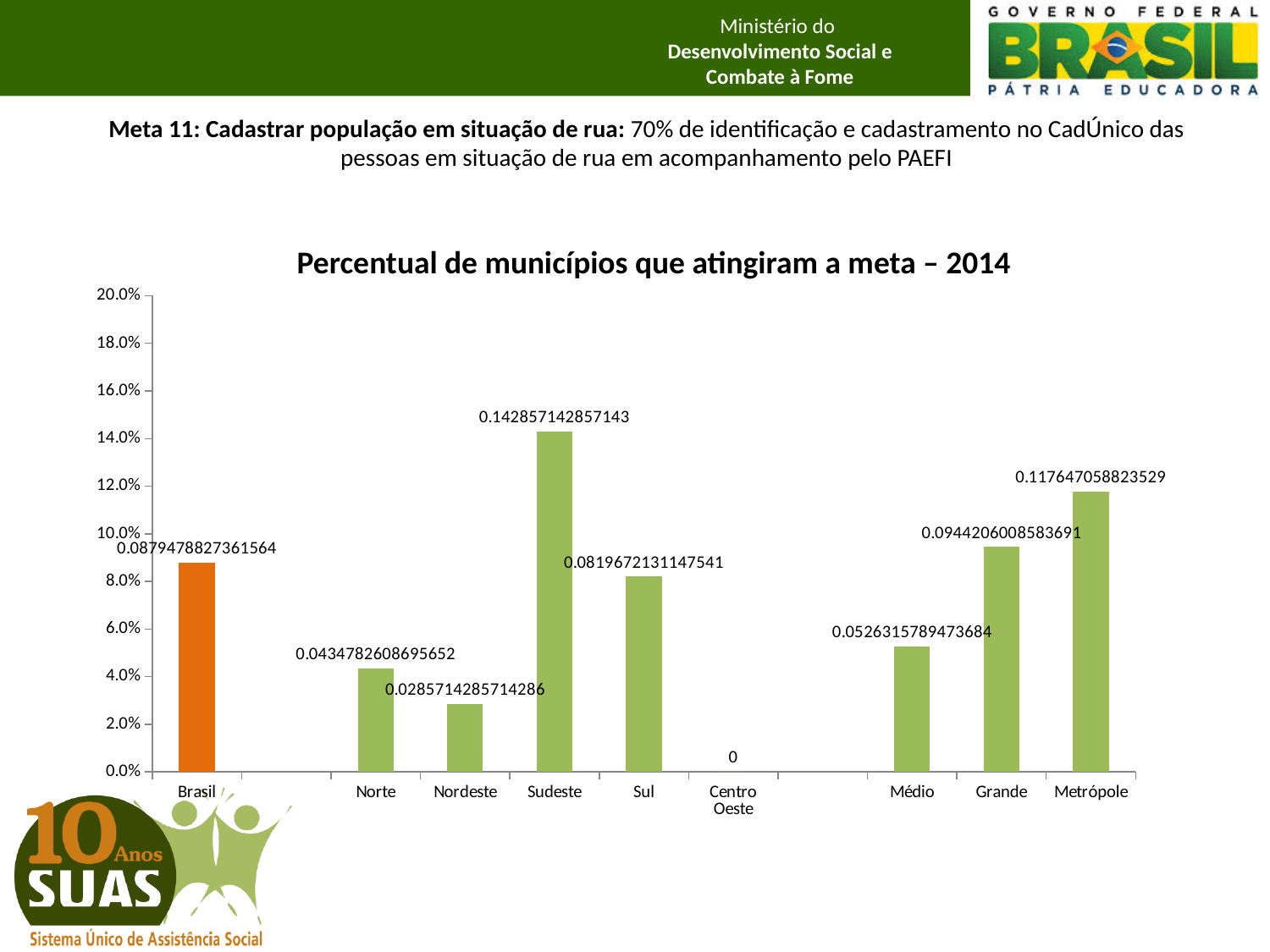
Which category has the lowest value? Centro Oeste Which category's bar is coloured orange rather than green? Brasil How many categories are shown on the x axis? 9 Is the value for Metrópole greater or less than 10.0%? greater What is the data label shown for Nordeste? 0.0285714285714286 What is the data label shown for Centro Oeste? 0 What is the data label shown for Brasil? 0.0879478827361564 What is the data label shown for Sudeste? 0.142857142857143 What is the data label shown for Metrópole? 0.117647058823529 Which is larger, the value for Grande or the value for Sul? Grande What kind of chart is shown on the slide? bar chart Which category has the highest bar? Sudeste